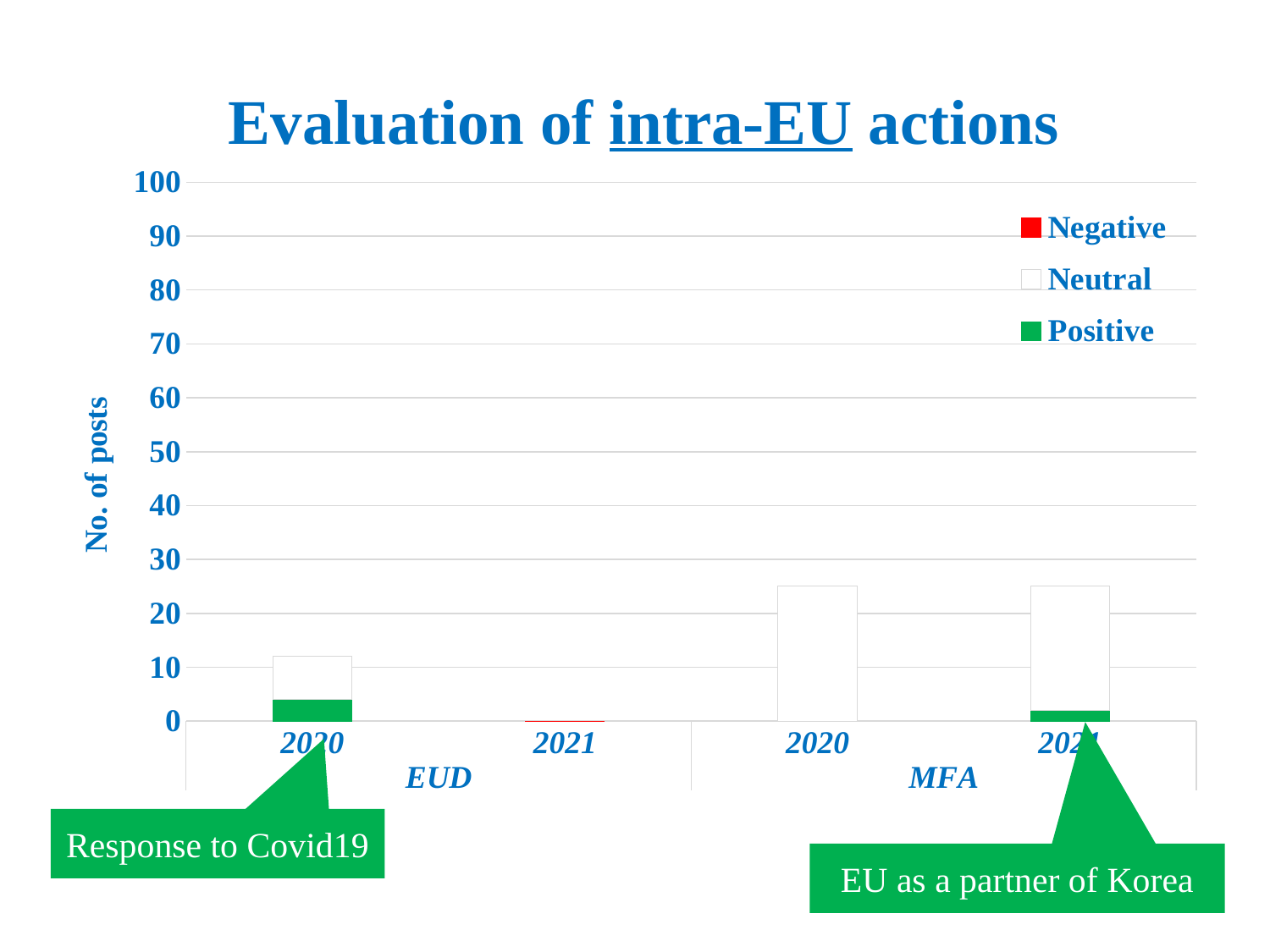
Which series is shown in green in the legend? Positive Is the total number of posts for EUD 2020 greater or less than 20? less What kind of chart is shown on the slide? Stacked bar chart How many series does the legend list? 3 Is the total number of posts for MFA 2020 greater or less than 20? greater Which has a larger total number of posts, EUD 2020 or MFA 2020? MFA 2020 What is the label on the vertical axis of the chart? No. of posts Is the total number of posts for MFA 2020 greater or less than 30? less How many bars (year-organisation categories) are plotted on the chart? 4 Which category has the lowest total number of posts? EUD 2021 Which has a larger total number of posts, EUD 2021 or MFA 2021? MFA 2021